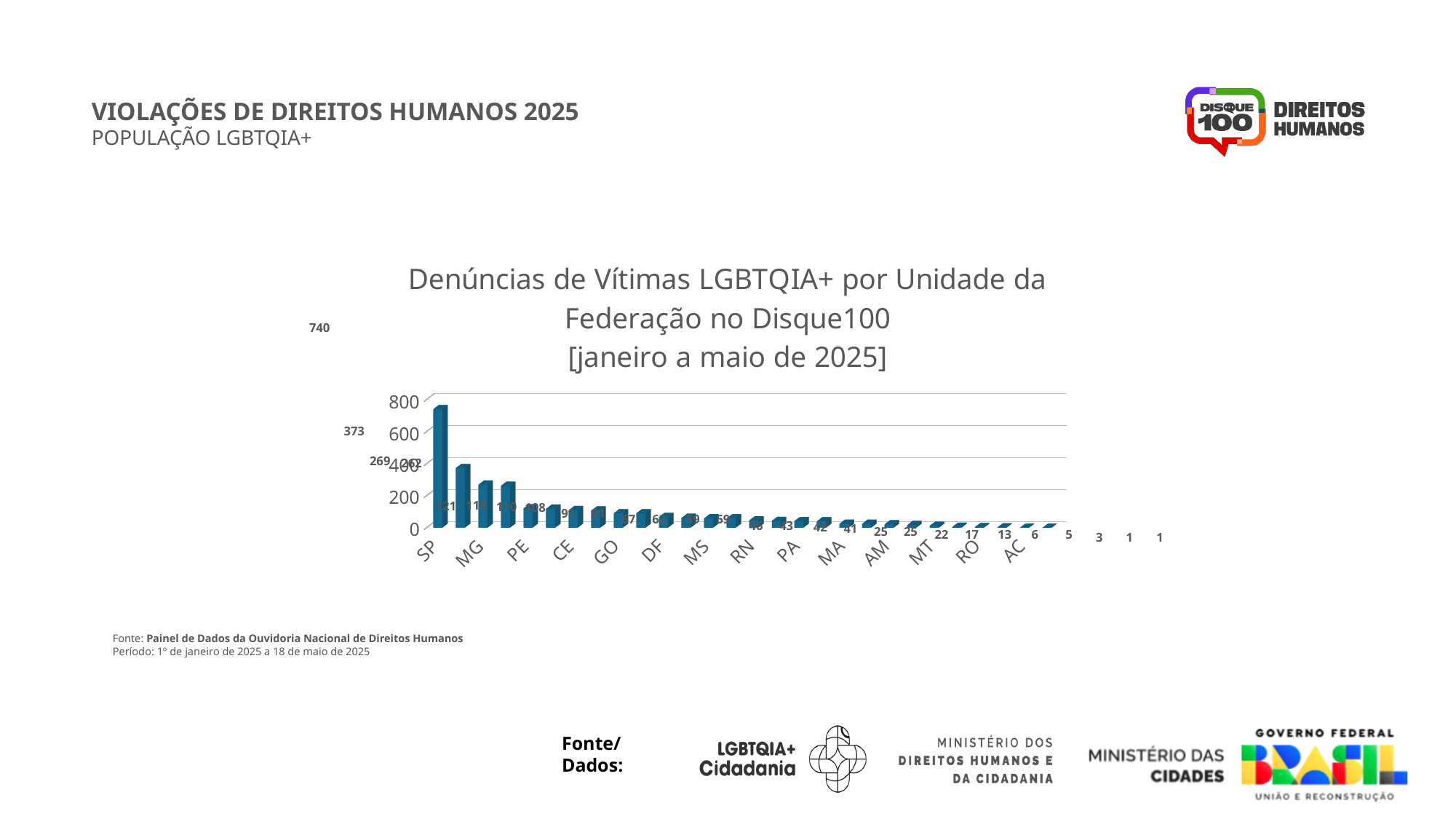
What period does the chart title say the data covers? janeiro a maio de 2025 Which has a larger value, SP or MG? SP What is the value shown for SP? 740 Which has a larger value, MG or AC? MG Is the value for SP greater or less than 600? greater What kind of chart is shown on the slide? bar chart Is the value for DF greater or less than 200? less Do the values rise or fall moving from left to right along the x axis? fall Which unit of the federation has the highest number of complaints in the chart? SP Is the value for AC greater or less than 200? less